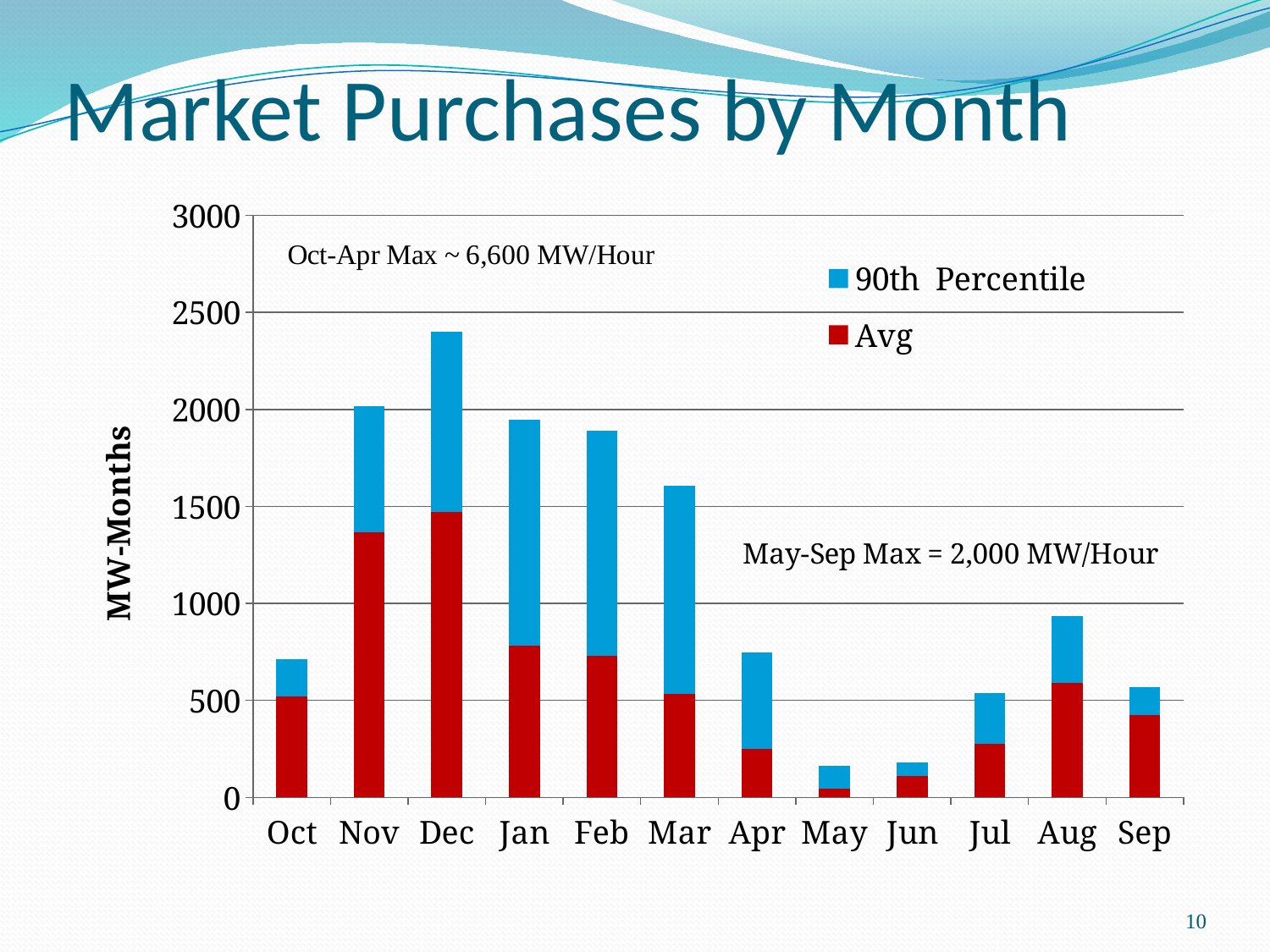
Is the total stacked bar for Dec greater or less than 2000? greater Which month has the smallest Avg value in the chart? May How many months are shown on the x axis of the chart? 12 What kind of chart is shown on the slide? bar chart Is the total stacked bar for Oct greater or less than 1000? less Which month has the larger Avg value, Jan or Mar? Jan What is the label on the chart's vertical axis? MW-Months Is the Avg value for Nov greater or less than 1000? greater Which month has the taller stacked bar, Nov or Jan? Nov How many series does the chart's legend list? 2 Which month has the tallest stacked bar in the chart? Dec